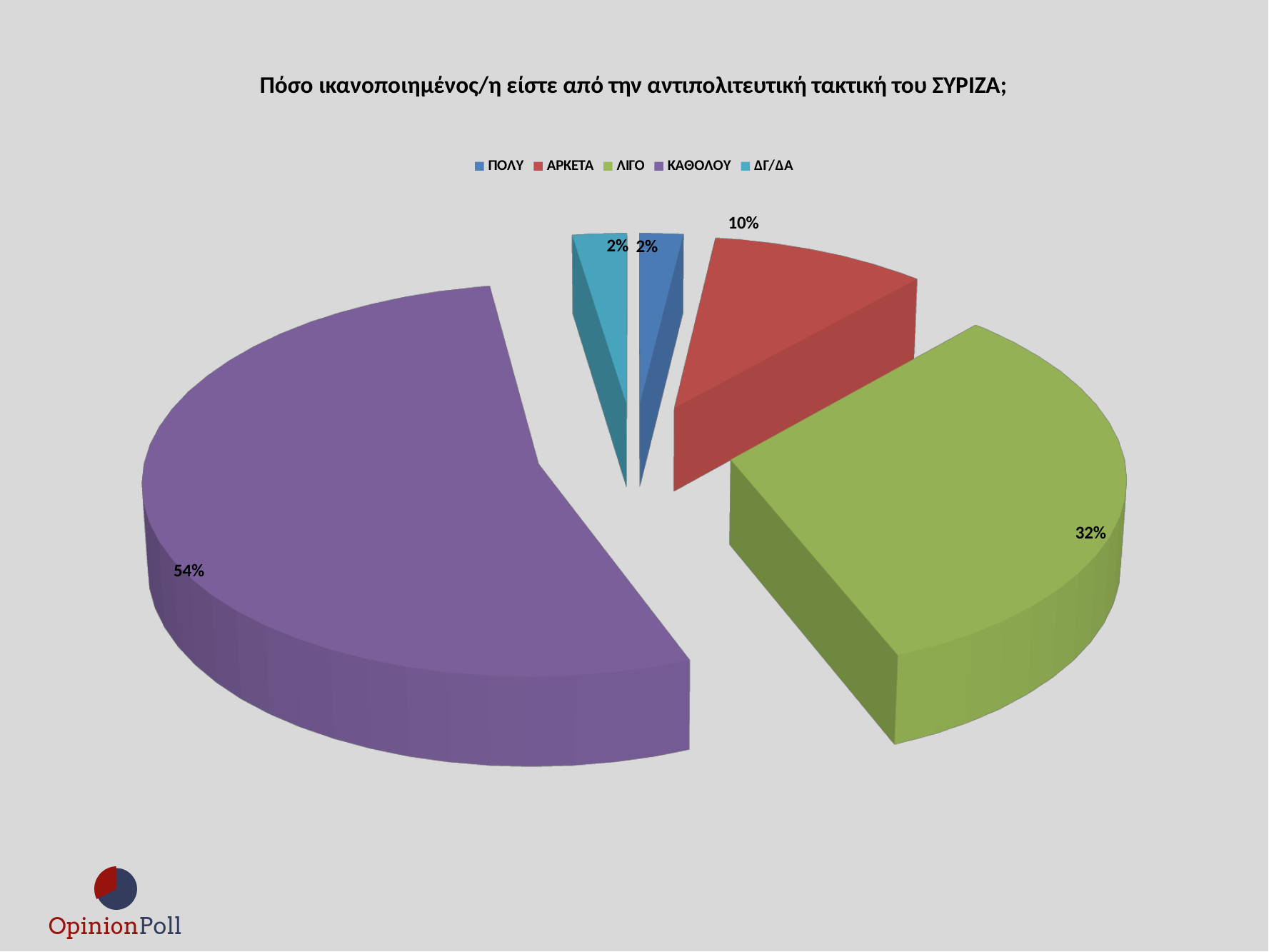
Which is larger, the share for ΑΡΚΕΤΑ or the share for ΛΙΓΟ? ΛΙΓΟ What percentage of respondents answered ΑΡΚΕΤΑ? 10% What percentage of respondents answered ΔΓ/ΔΑ? 2% What is the combined share of ΠΟΛΥ and ΑΡΚΕΤΑ? 12% What type of chart is shown on the slide? Pie chart What colour is the ΚΑΘΟΛΟΥ slice? Purple What percentage of respondents answered ΛΙΓΟ? 32% What percentage of respondents answered ΚΑΘΟΛΟΥ? 54% What is the difference in percentage points between ΚΑΘΟΛΟΥ and ΛΙΓΟ? 22 How many categories does the legend list? 5 What percentage of respondents answered ΠΟΛΥ? 2% Which response category has the largest share of the pie? ΚΑΘΟΛΟΥ